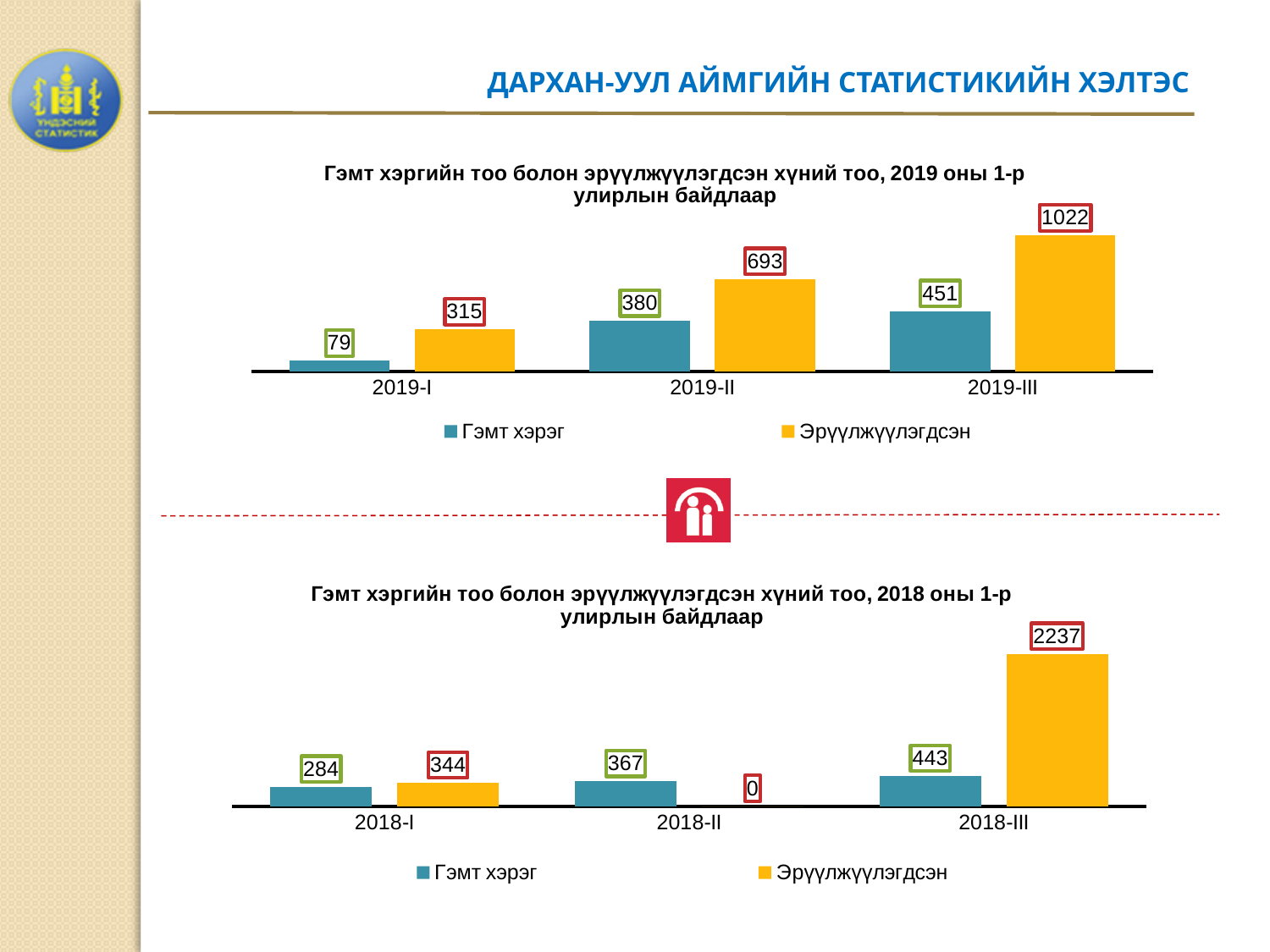
In the top chart (2019), what is the value of Эрүүлжүүлэгдсэн for 2019-III? 1022 In the top chart (2019), how many series does the legend list? 2 In the bottom chart (2018), which category has the lowest Гэмт хэрэг value? 2018-I In the top chart (2019), does the Гэмт хэрэг series rise or fall from 2019-I to 2019-III? rise In the bottom chart (2018), which is larger for 2018-I: Гэмт хэрэг or Эрүүлжүүлэгдсэн? Эрүүлжүүлэгдсэн In the bottom chart (2018), what is the value of Эрүүлжүүлэгдсэн for 2018-II? 0 In the bottom chart (2018), what is the value of Гэмт хэрэг for 2018-III? 443 In the bottom chart (2018), what is the difference between Эрүүлжүүлэгдсэн and Гэмт хэрэг for 2018-III? 1794 In the top chart (2019), which category has the highest Эрүүлжүүлэгдсэн value? 2019-III In the top chart (2019), what is the value of Гэмт хэрэг for 2019-I? 79 What kind of chart is the bottom chart (2018)? bar chart In the top chart (2019), what is the difference between Эрүүлжүүлэгдсэн and Гэмт хэрэг for 2019-II? 313